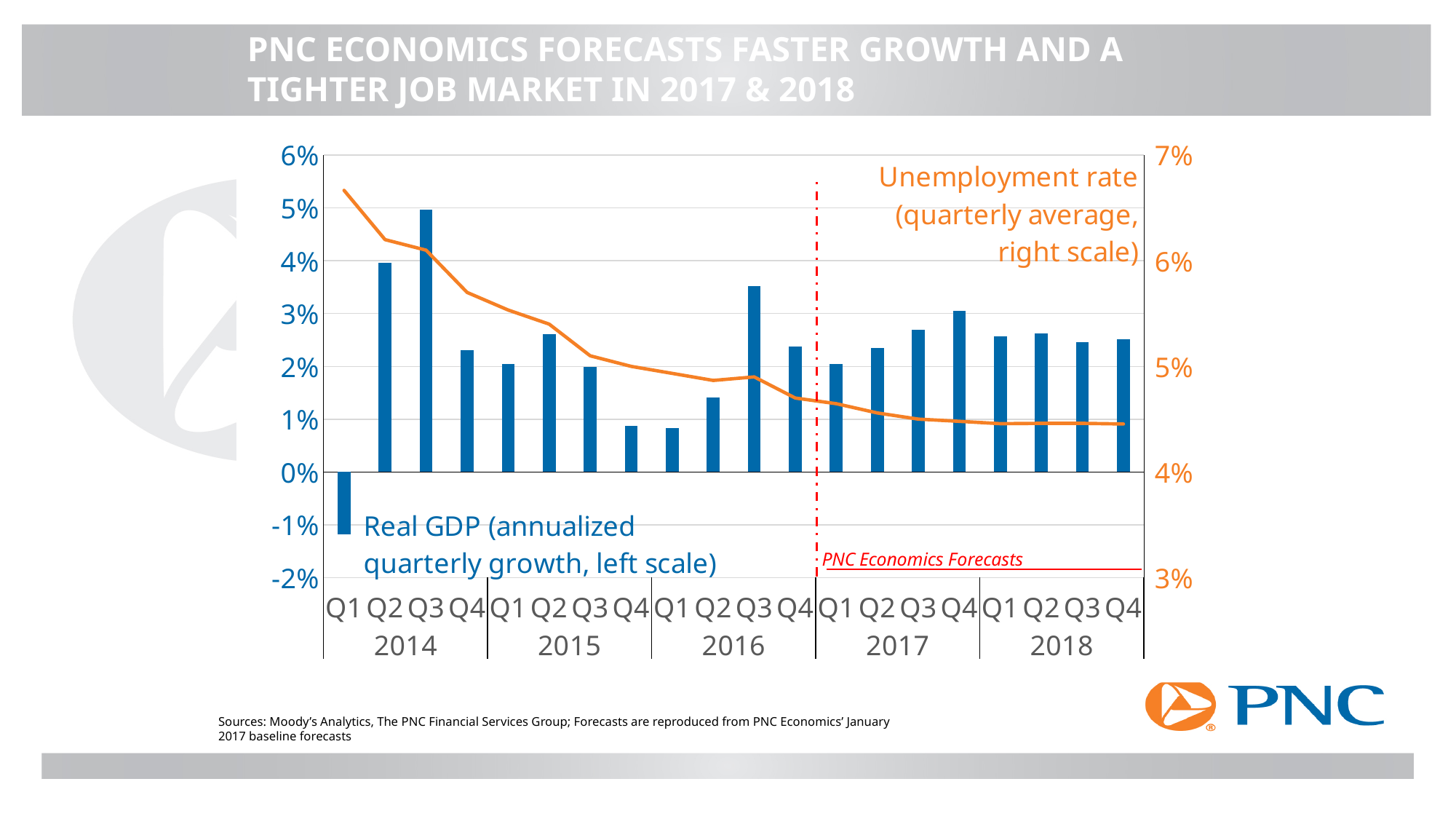
Is the unemployment rate for Q1 2014 greater or less than 6%? greater Does the unemployment rate rise or fall from 2014 to 2018? fall How many quarters are plotted along the x axis? 20 In which quarter is real GDP growth lowest? Q1 2014 Is the unemployment rate for Q4 2018 greater or less than 5%? less What does the red dashed vertical line mark on the chart? PNC Economics Forecasts What kind of chart is shown on the slide? A bar chart combined with a line Is the real GDP growth value for Q3 2016 greater or less than 3%? greater Which quarter has higher real GDP growth, Q2 2016 or Q3 2016? Q3 2016 In which quarter is real GDP growth highest? Q3 2014